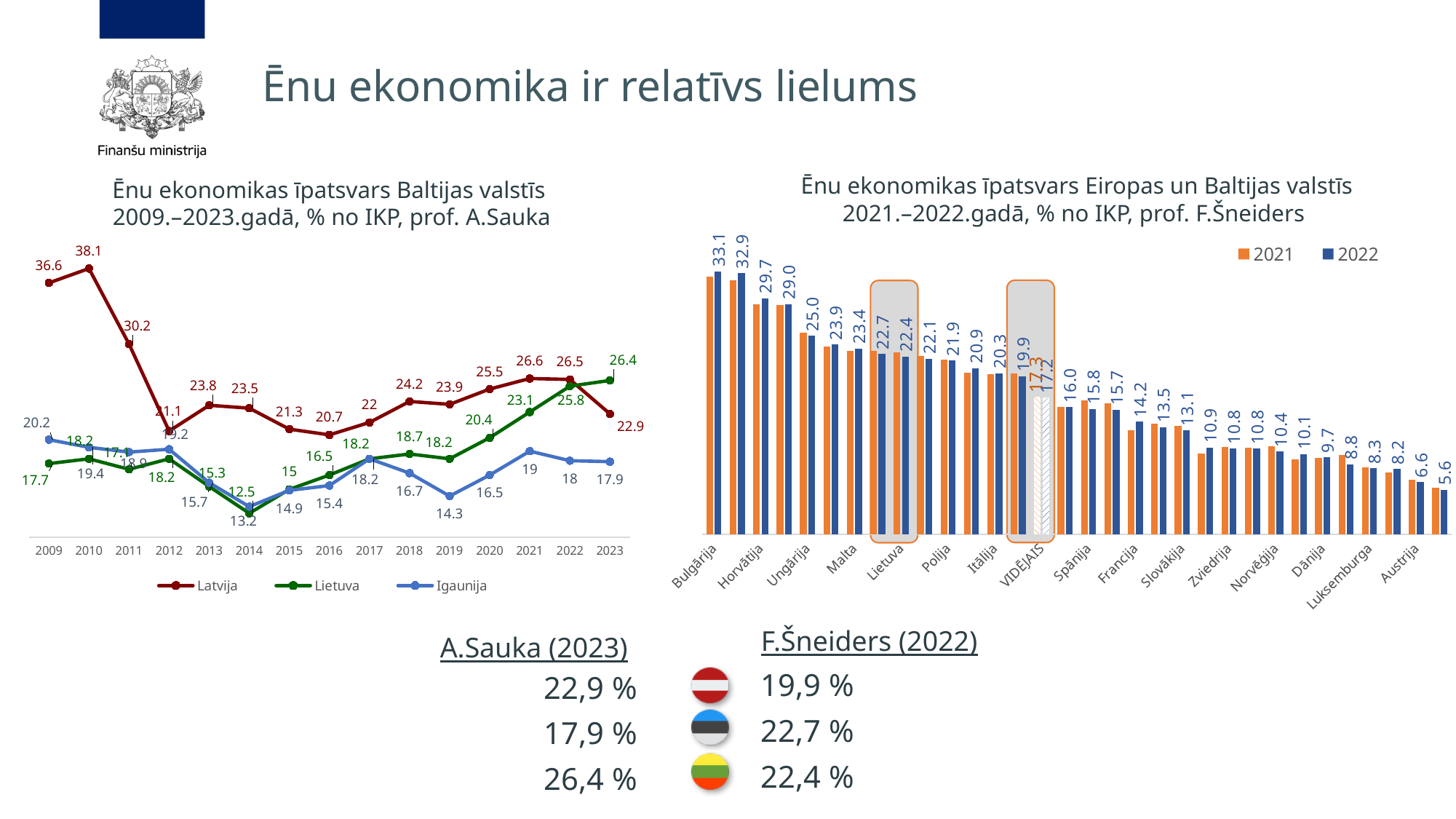
In the left chart (Ēnu ekonomikas īpatsvars Baltijas valstīs), what is the difference between the Lietuva and Latvija values in 2023? 3.5 In the left chart (Ēnu ekonomikas īpatsvars Baltijas valstīs), does the Lietuva line rise or fall from 2019 to 2023? rise In the left chart (Ēnu ekonomikas īpatsvars Baltijas valstīs), in which year does Latvija reach its highest value? 2010 In the left chart (Ēnu ekonomikas īpatsvars Baltijas valstīs), what is the value for Latvija in 2010? 38.1 In the right chart (Ēnu ekonomikas īpatsvars Eiropas un Baltijas valstīs), what is the 2022 value for Lietuva? 22.4 What kind of chart is the right chart (Ēnu ekonomikas īpatsvars Eiropas un Baltijas valstīs)? bar chart In the left chart (Ēnu ekonomikas īpatsvars Baltijas valstīs), how many years are shown on the x axis? 15 In the left chart (Ēnu ekonomikas īpatsvars Baltijas valstīs), how many series does the legend list? 3 In the left chart (Ēnu ekonomikas īpatsvars Baltijas valstīs), what is the value for Lietuva in 2014? 12.5 In the right chart (Ēnu ekonomikas īpatsvars Eiropas un Baltijas valstīs), what is the 2022 value for Bulgārija? 33.1 In the left chart (Ēnu ekonomikas īpatsvars Baltijas valstīs), which is larger in 2009, Latvija or Igaunija? Latvija In the left chart (Ēnu ekonomikas īpatsvars Baltijas valstīs), what is the value for Igaunija in 2023? 17.9